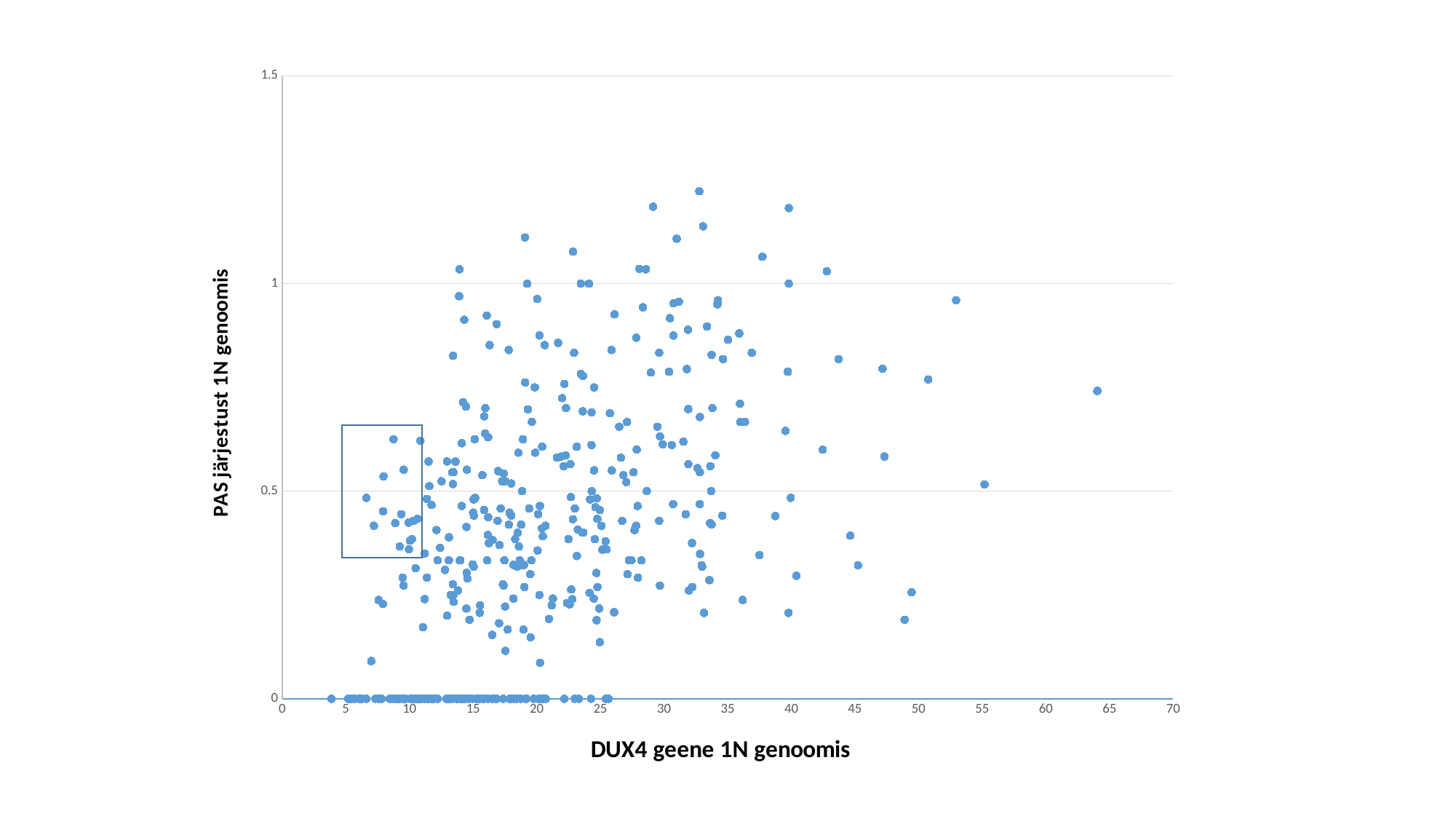
Is the y value of the highest point greater or less than 1.5? less What is the highest tick value shown on the vertical axis? 1.5 Is the x value of the rightmost point greater or less than 70? less What is the label of the horizontal axis? DUX4 geene 1N genoomis Is the x value of the point at the far right (around y = 0.5) greater or less than 50? greater What is the highest tick value shown on the horizontal axis? 70 What is the label of the vertical axis? PAS järjestust 1N genoomis What kind of chart is shown on the slide? scatter plot